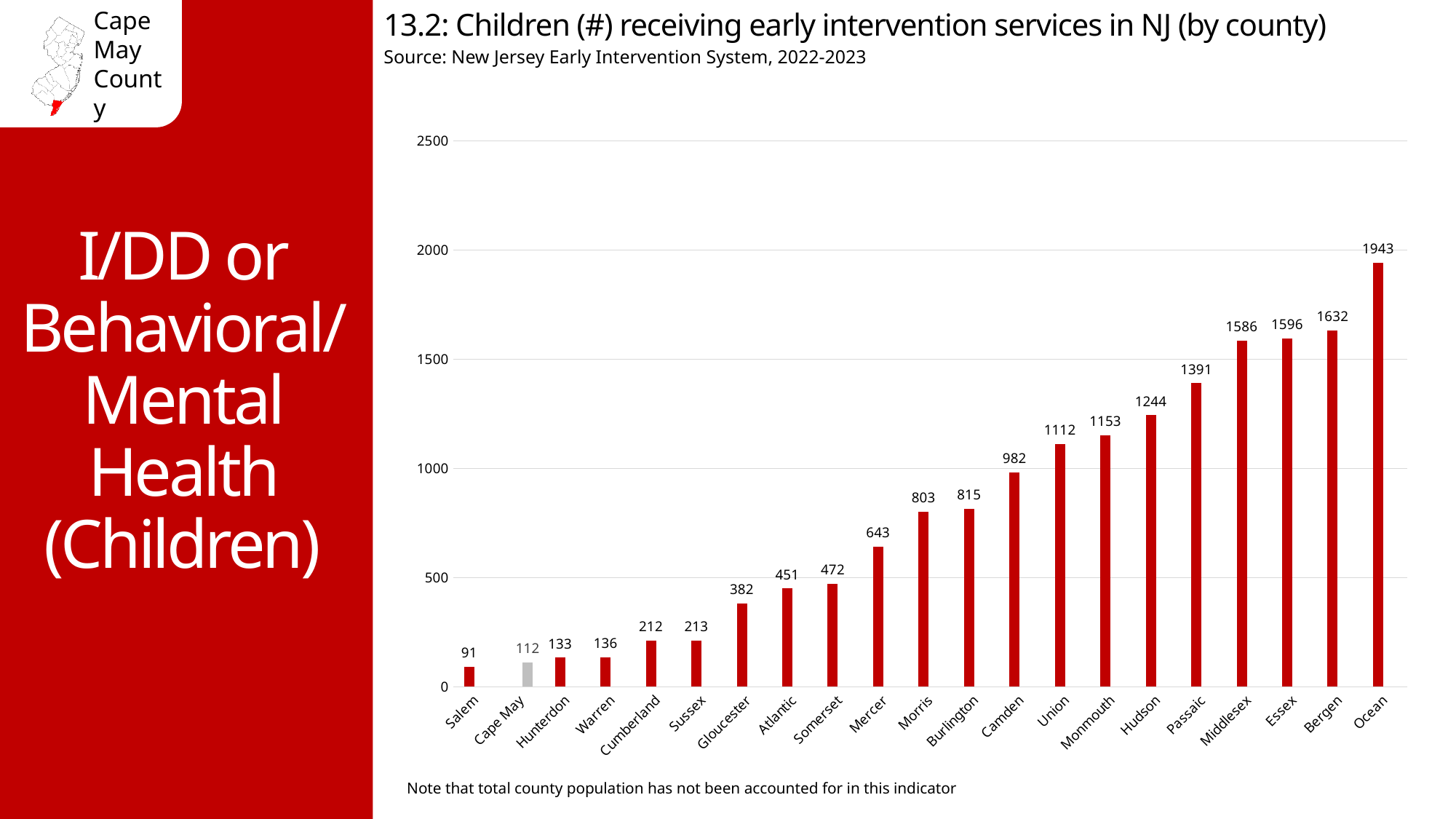
How many counties are shown on the chart? 21 Which county has the highest number of children receiving early intervention services? Ocean Which county's bar is shown in grey rather than red? Cape May What is the value shown for Mercer County? 643 What kind of chart is shown on the slide? Bar chart Is the value for Passaic greater or less than 1500? less How many children are receiving early intervention services in Cape May County? 112 What is the difference between the values for Cape May and Salem? 21 Which county has the lowest number of children receiving early intervention services? Salem What is the difference between the values for Bergen and Essex? 36 What is the value shown for Ocean County? 1943 Which county has a larger value, Camden or Union? Union